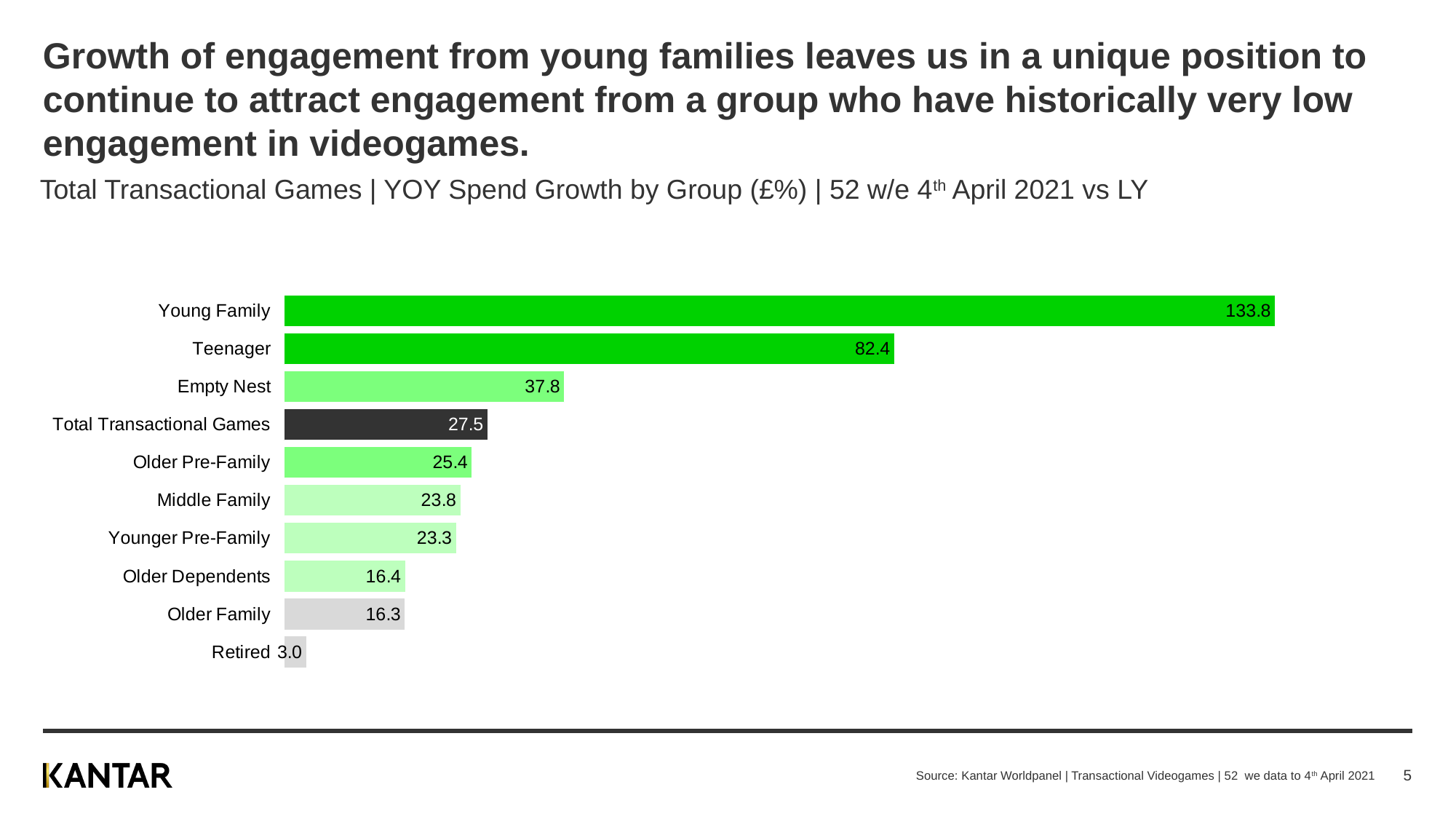
What is the difference between the values for Young Family and Teenager? 51.4 Which has a larger value, Older Pre-Family or Middle Family? Older Pre-Family Which group has the highest YOY spend growth? Young Family What is the value shown for Retired? 3.0 Which bar is coloured dark grey/black rather than green? Total Transactional Games What is the YOY spend growth value for Teenager? 82.4 How many bars are shown in the chart? 10 What is the value shown for Total Transactional Games? 27.5 What is the difference between the values for Empty Nest and Total Transactional Games? 10.3 Which group has the lowest YOY spend growth? Retired What is the YOY spend growth value for Young Family? 133.8 What kind of chart is shown on the slide? Bar chart